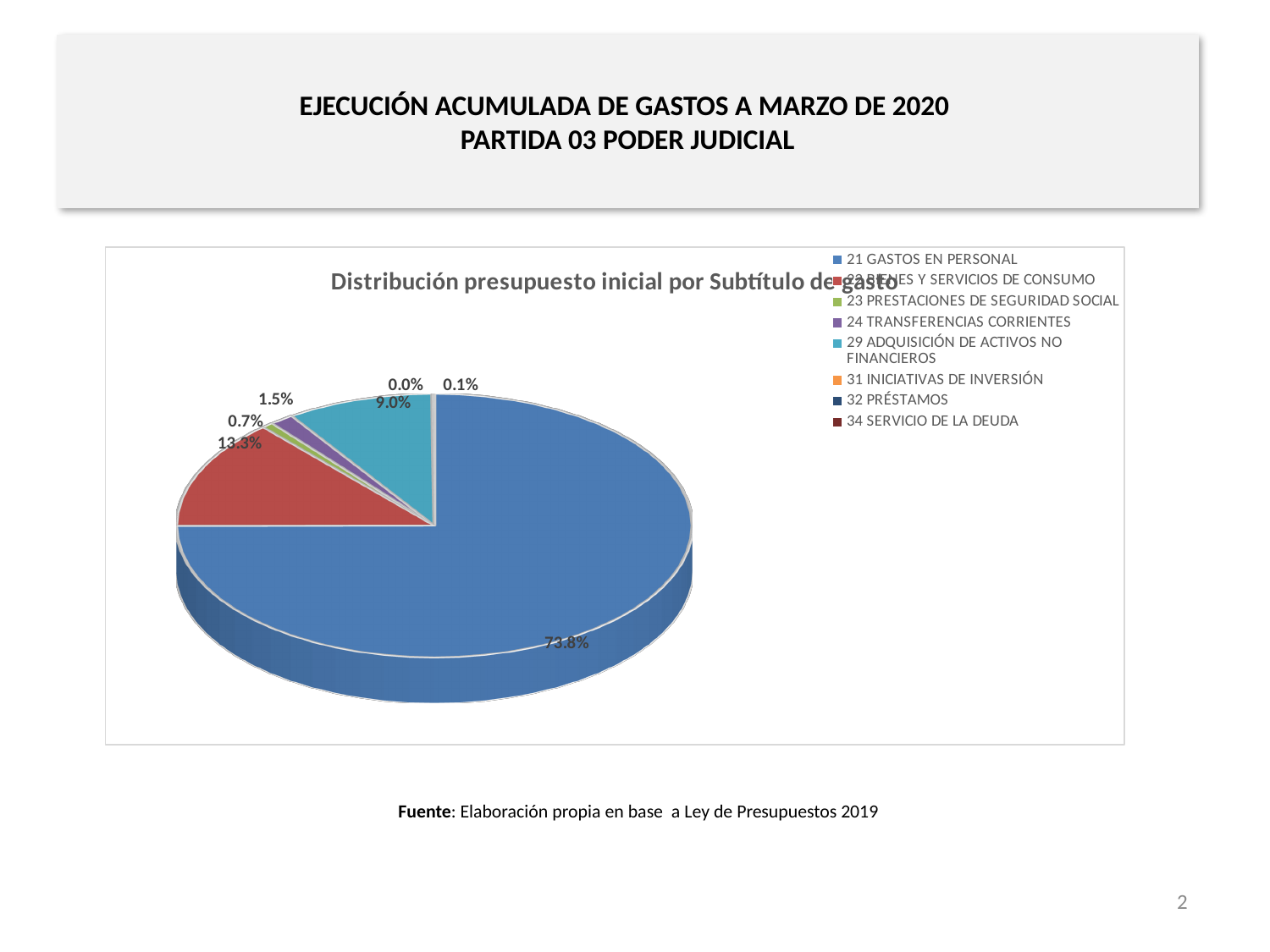
Which has a larger share, 29 ADQUISICIÓN DE ACTIVOS NO FINANCIEROS or 24 TRANSFERENCIAS CORRIENTES? 29 ADQUISICIÓN DE ACTIVOS NO FINANCIEROS What share of the pie does 22 BIENES Y SERVICIOS DE CONSUMO have? 13.3% What is the difference in percentage points between the share of 21 GASTOS EN PERSONAL and 22 BIENES Y SERVICIOS DE CONSUMO? 60.5 percentage points What share of the pie does 23 PRESTACIONES DE SEGURIDAD SOCIAL have? 0.7% What share of the pie does 24 TRANSFERENCIAS CORRIENTES have? 1.5% Which category has the largest share of the pie? 21 GASTOS EN PERSONAL What is the title of the chart? Distribución presupuesto inicial por Subtítulo de gasto What kind of chart is shown on the slide? Pie chart What colour is the slice for 21 GASTOS EN PERSONAL? Blue How many entries does the chart legend list? 8